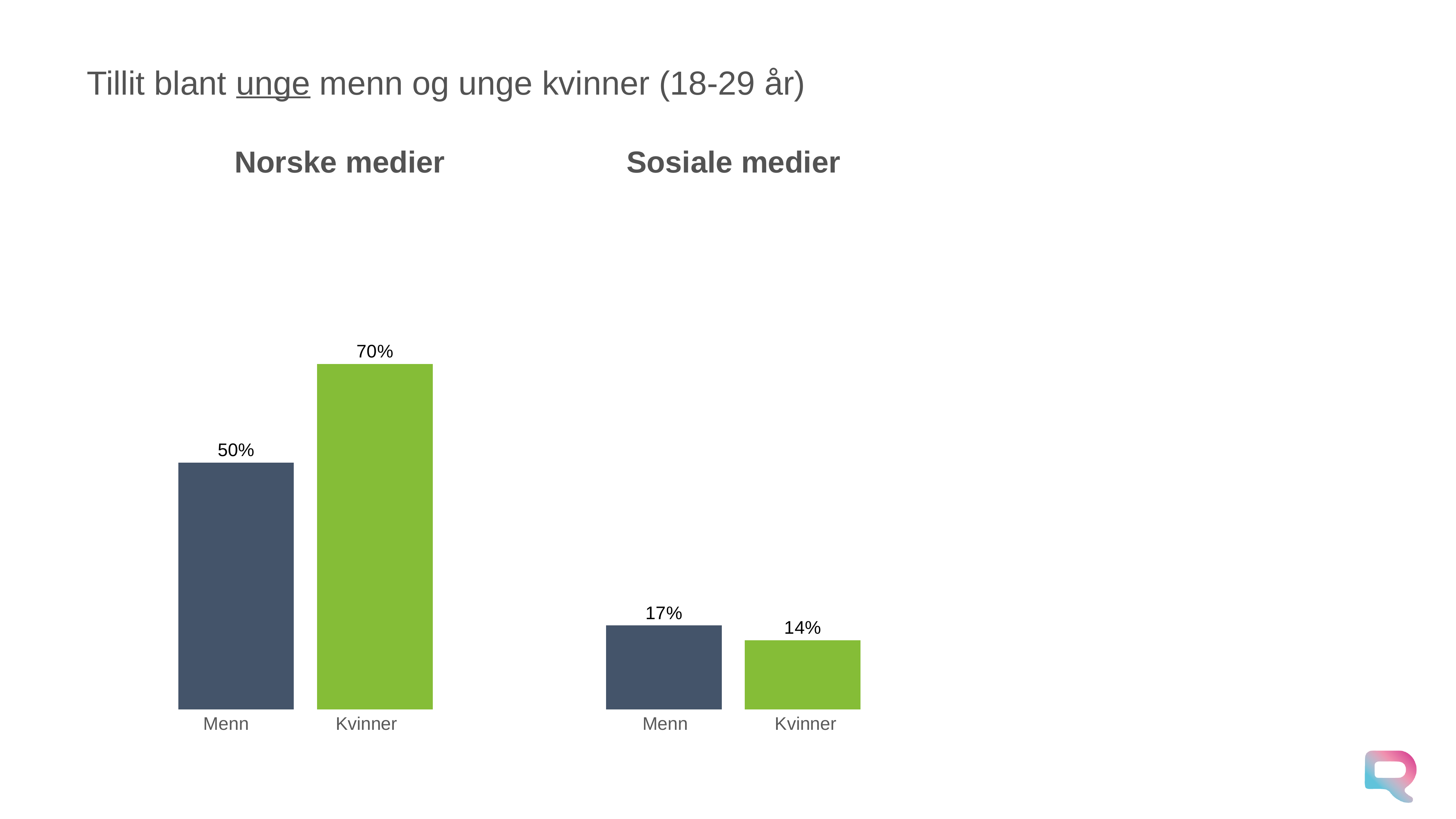
What is the title of the chart on the left? Norske medier How many categories does the Norske medier chart show? 2 In the Sosiale medier chart, which category has the lowest value? Kvinner What kind of chart is the Sosiale medier chart? Bar chart In the Sosiale medier chart, what is the value for Kvinner? 14% In the Sosiale medier chart, what is the difference between the values for Menn and Kvinner? 3% In the Norske medier chart, what is the value for Kvinner? 70% In the Sosiale medier chart, what is the value for Menn? 17% In the Norske medier chart, what is the difference between the values for Kvinner and Menn? 20% In the Sosiale medier chart, which is larger, the value for Menn or the value for Kvinner? Menn In the Norske medier chart, what is the value for Menn? 50% In the Norske medier chart, which category has the highest value? Kvinner